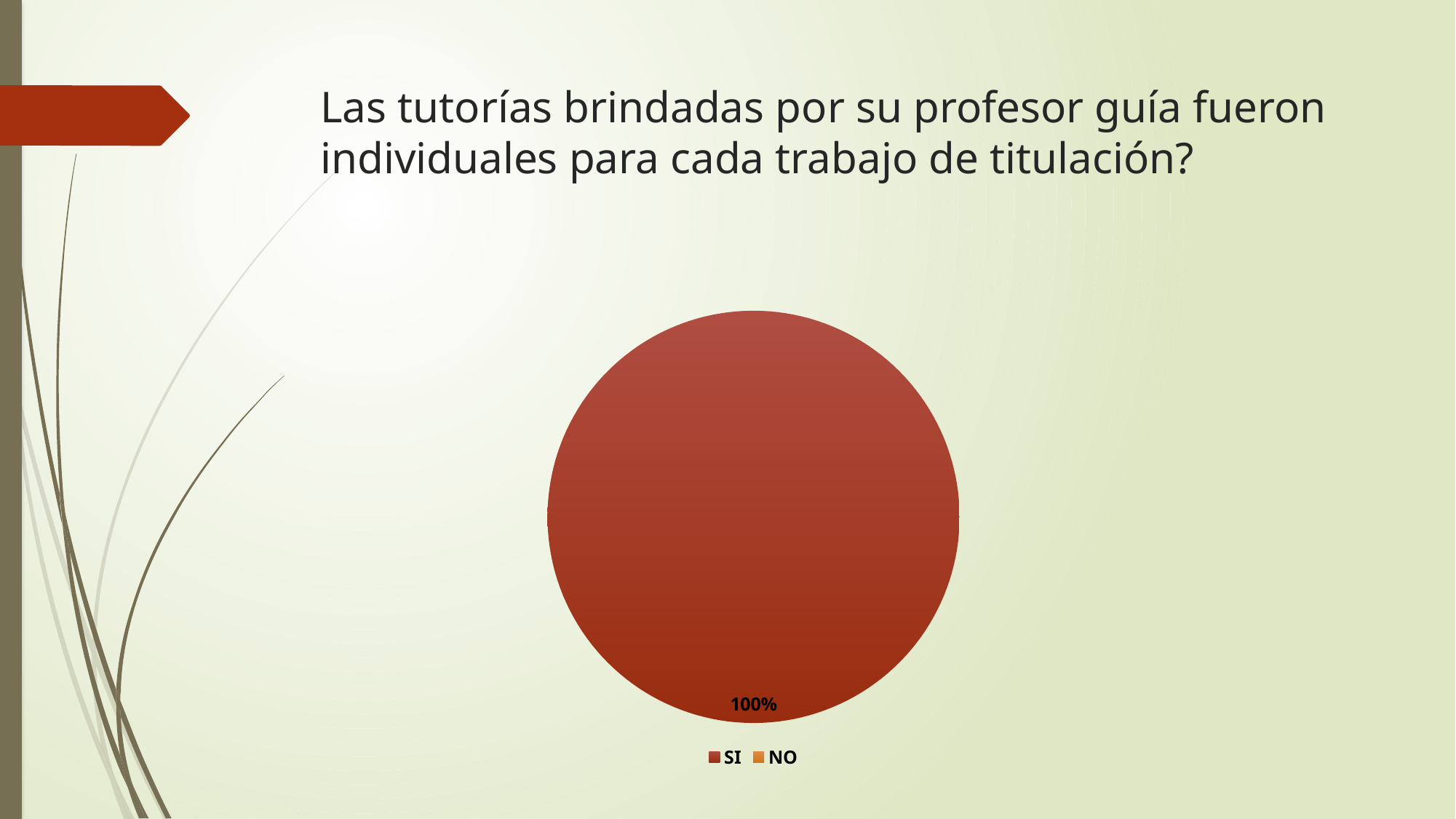
Is the value for SI greater or less than 50%? greater What are the two legend entries of the pie chart? SI and NO What share of the pie does the SI slice represent? 100% Which category has the largest share of the pie chart? SI Which category has the smallest share of the pie chart? NO What kind of chart is shown on the slide? pie chart What colour is the SI slice in the pie chart? red What percentage is shown for SI in the pie chart? 100% Which of the two categories, SI or NO, has the larger share of the pie? SI How many entries does the legend of the pie chart list? 2